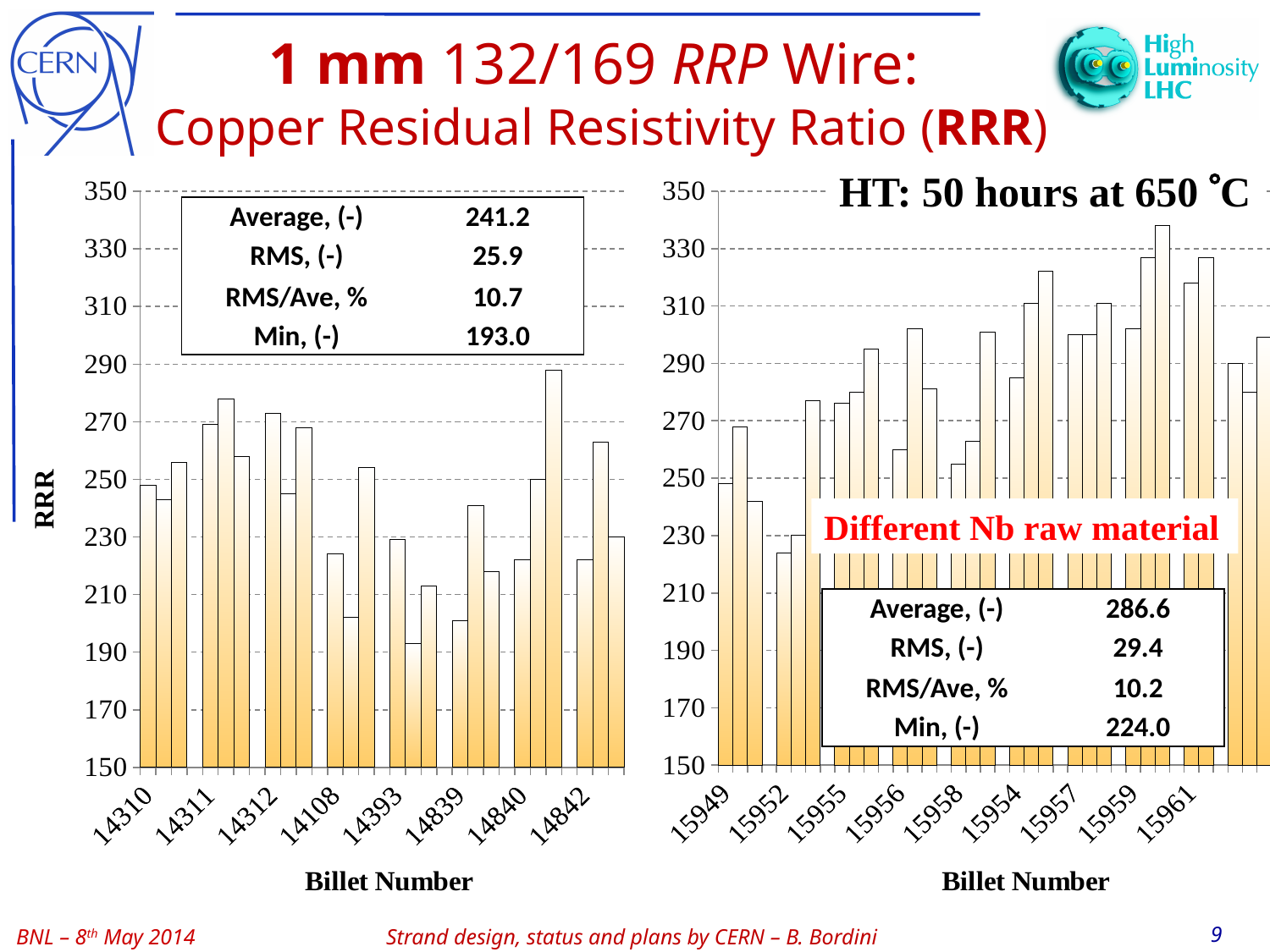
What is the label on the x axis of the right chart? Billet Number How many billet numbers are labelled on the x axis of the right chart? 9 What is the label on the y axis of the left chart? RRR Which chart has the taller maximum bar, the left chart or the right chart? the right chart In the right chart, is the tallest bar greater or less than 330? greater What type of chart is the left chart on the slide? bar chart In the left chart, is the shortest bar greater or less than 210? less In the right chart, is the shortest bar greater or less than 250? less How many billet numbers are labelled on the x axis of the left chart? 8 What average value is shown in the statistics box on the right chart? 286.6